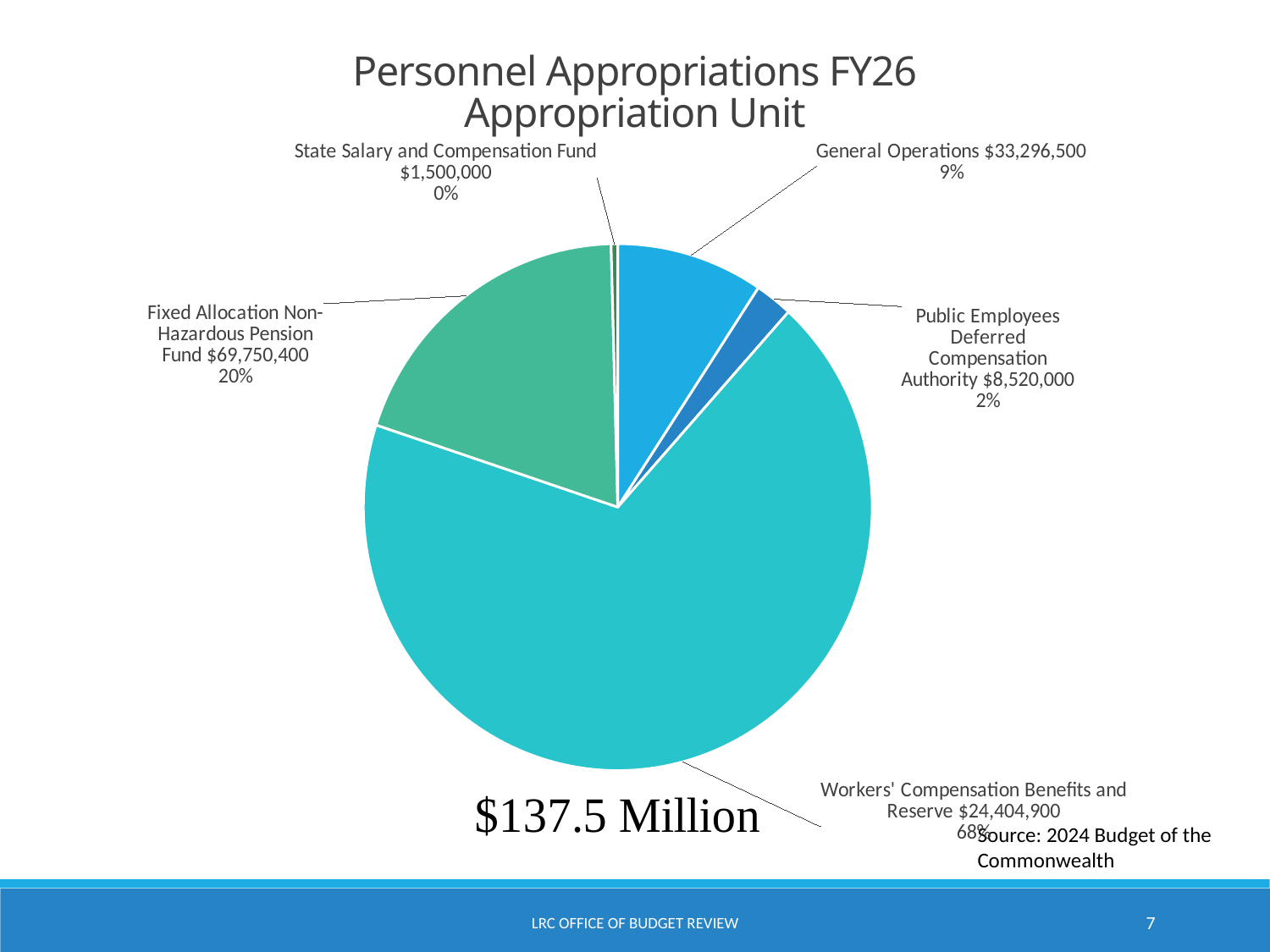
What kind of chart is shown on the slide? Pie chart What percentage share is shown for Workers' Compensation Benefits and Reserve? 68% Which is larger, the amount for General Operations or the amount for the Public Employees Deferred Compensation Authority? General Operations What dollar amount is shown for the Public Employees Deferred Compensation Authority? $8,520,000 What dollar amount is shown for General Operations? $33,296,500 How many slices does the pie chart have? 5 What is the difference between the amount for the Fixed Allocation Non-Hazardous Pension Fund and the amount for General Operations? $36,453,900 Which category has the smallest slice of the pie? State Salary and Compensation Fund What dollar amount is shown for the Fixed Allocation Non-Hazardous Pension Fund? $69,750,400 What percentage share is shown for the Fixed Allocation Non-Hazardous Pension Fund? 20% Which category has the largest slice of the pie? Workers' Compensation Benefits and Reserve What is the title of the chart? Personnel Appropriations FY26 Appropriation Unit